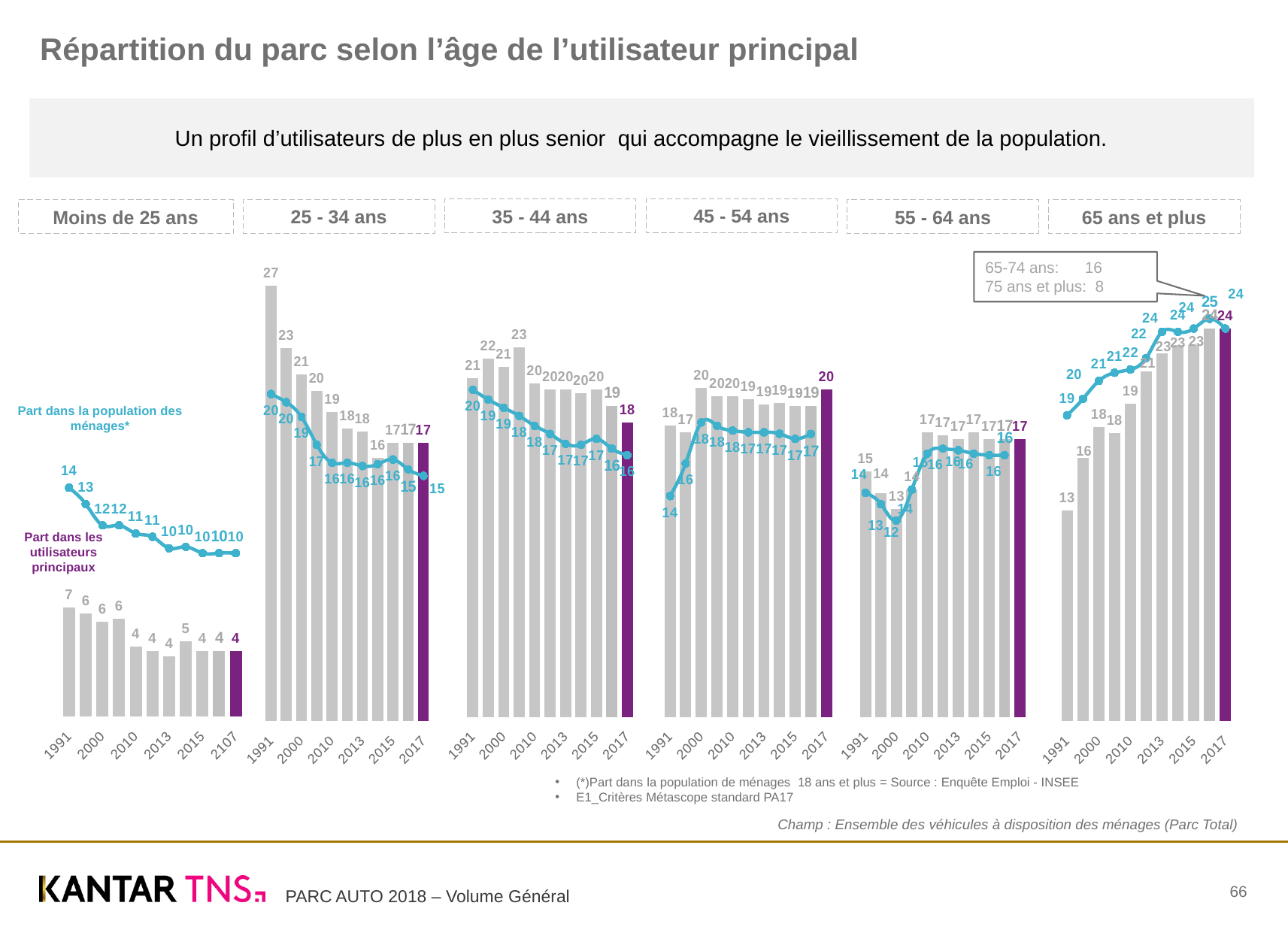
How many age-group charts are shown on the slide? 6 In the '25 - 34 ans' chart, what is the value of the first bar (1991)? 27 In the '45 - 54 ans' chart, what is the value of the purple bar for 2017? 20 In the 'Moins de 25 ans' chart, what is the value of the first bar (1991)? 7 In the 'Moins de 25 ans' chart, do the bar values rise or fall from 1991 to 2017? fall Which is larger in 2017: the purple bar in the '65 ans et plus' chart or the purple bar in the '25 - 34 ans' chart? 65 ans et plus In the '25 - 34 ans' chart, what is the difference between the first bar (27) and the last bar (17)? 10 According to the callout on the '65 ans et plus' chart, what is the value for '75 ans et plus'? 8 In the '65 ans et plus' chart, what is the value of the purple bar for 2017? 24 In the '35 - 44 ans' chart, what is the highest bar value shown? 23 In the '55 - 64 ans' chart, what is the lowest value of the blue line? 12 In the '65 ans et plus' chart, do the bar values rise or fall from 1991 to 2017? rise